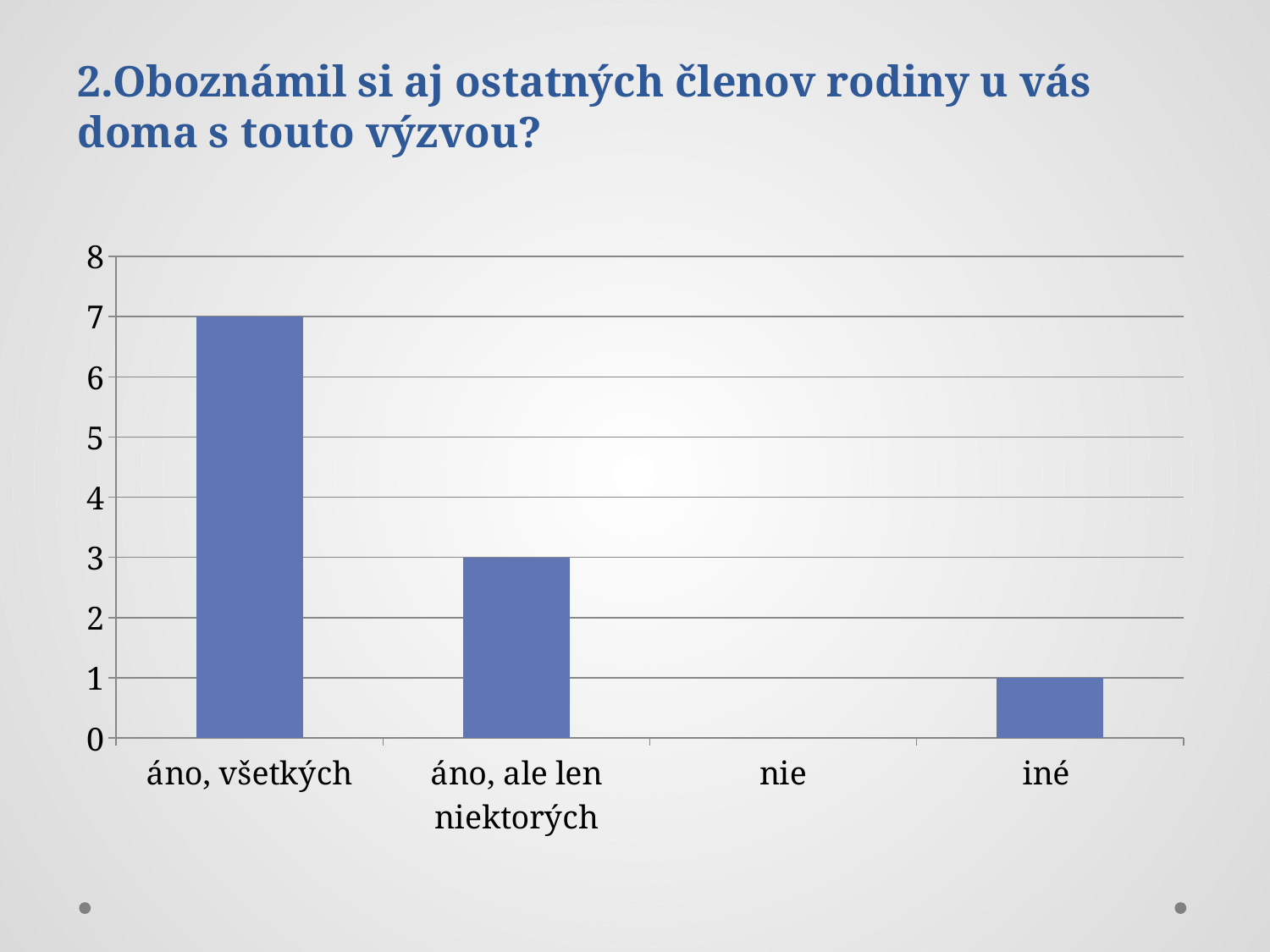
Which category has the lowest value? nie What kind of chart is shown on the slide? bar chart What is the value for "iné"? 1 What is the highest value shown on the y axis? 8 What is the value for "nie"? 0 Is the value for "áno, všetkých" greater or less than 5? greater How many categories are shown on the x axis? 4 What is the value for "áno, ale len niektorých"? 3 Which is larger, the value for "áno, ale len niektorých" or the value for "iné"? áno, ale len niektorých What is the value for "áno, všetkých"? 7 What is the difference between the values for "áno, všetkých" and "áno, ale len niektorých"? 4 Which category has the highest value? áno, všetkých